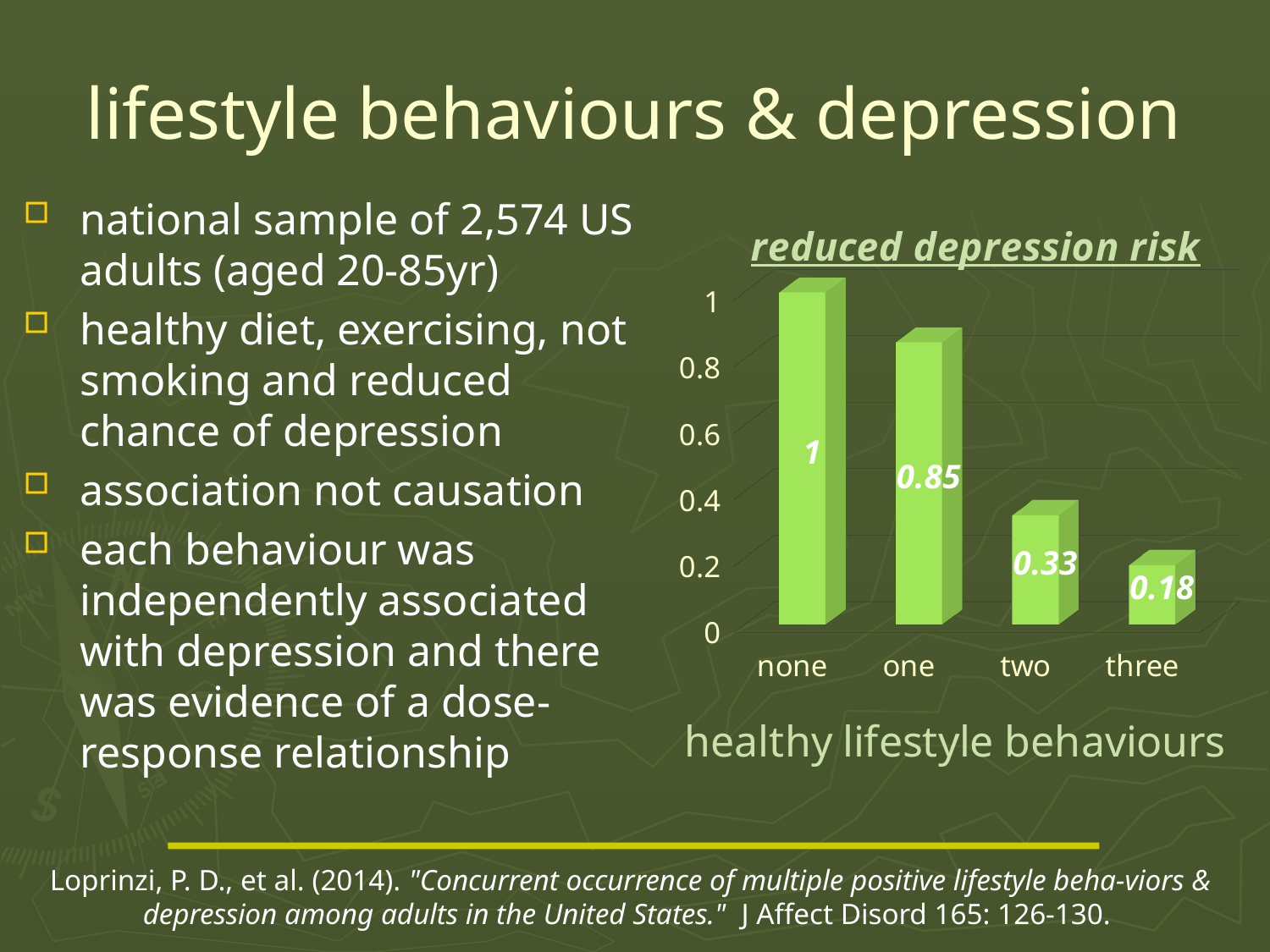
What is the value for "three" healthy lifestyle behaviours? 0.18 What is the value for "two" healthy lifestyle behaviours? 0.33 What is the difference between the values for "one" and "two"? 0.52 Which is larger, the value for "two" or the value for "three"? two What is the title of the chart? reduced depression risk Do the values rise or fall from "none" to "three" along the x axis? fall Which category has the highest value? none What kind of chart is shown on the slide? bar chart Which category has the lowest value? three How many categories are shown on the x axis? 4 What is the value for "one" healthy lifestyle behaviour? 0.85 What is the value for "none" healthy lifestyle behaviours? 1